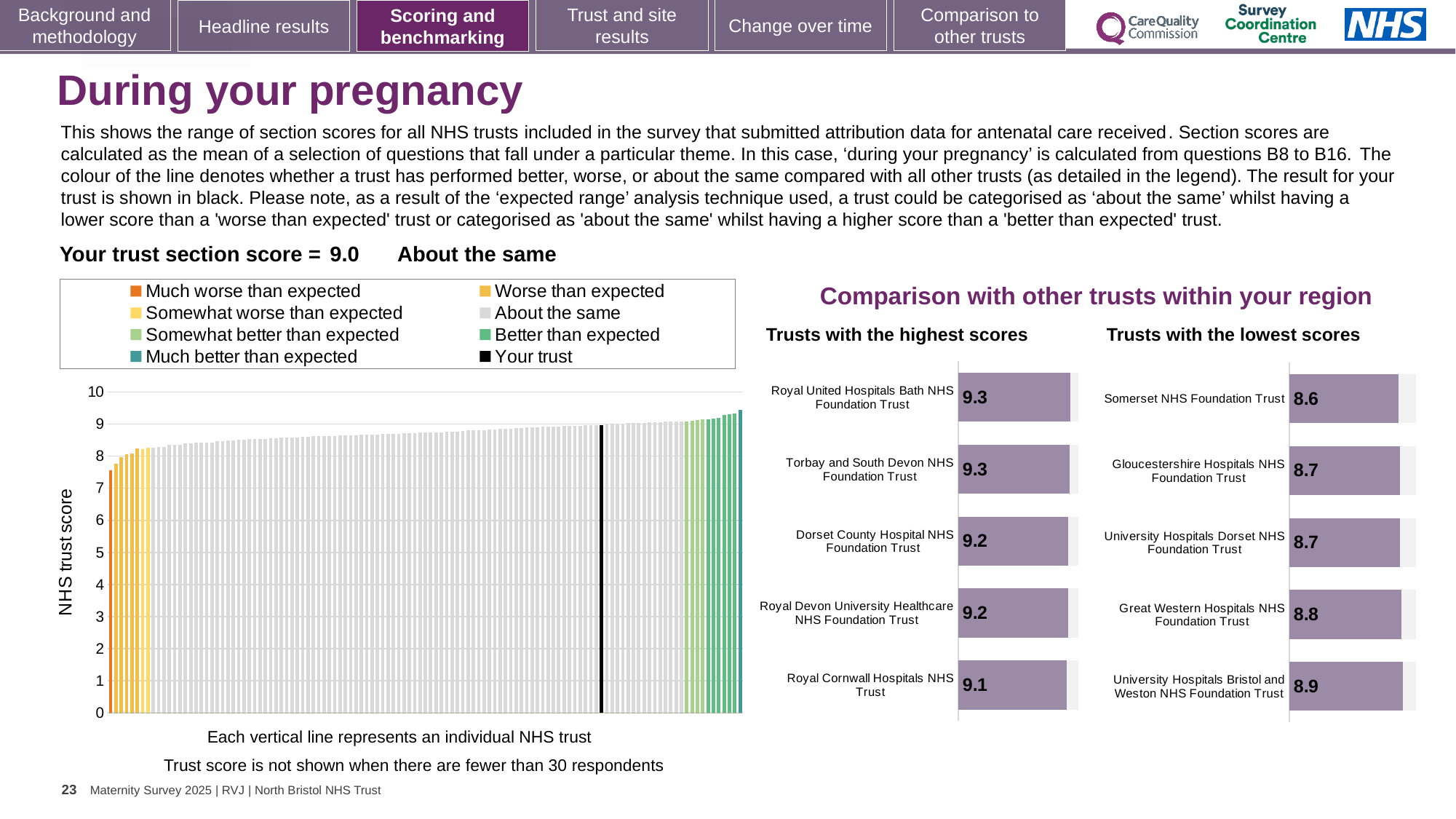
In the 'Trusts with the highest scores' chart, which trust has the lowest score? Royal Cornwall Hospitals NHS Trust How many entries does the legend above the 'NHS trust score' chart list? 8 In the 'Trusts with the highest scores' chart, what is the score for Royal Cornwall Hospitals NHS Trust? 9.1 In the 'NHS trust score' chart, is the value of the leftmost bar greater or less than 8? less In the 'NHS trust score' chart, do the bar values rise or fall from left to right? Rise In the 'Trusts with the lowest scores' chart, what is the difference between the scores of University Hospitals Bristol and Weston NHS Foundation Trust and Somerset NHS Foundation Trust? 0.3 How many trusts are shown in the 'Trusts with the highest scores' chart? 5 In the 'Trusts with the highest scores' chart, what is the difference between the scores of Royal United Hospitals Bath NHS Foundation Trust and Royal Cornwall Hospitals NHS Trust? 0.2 What kind of chart is the 'NHS trust score' chart on the left of the slide? Bar chart In the 'Trusts with the lowest scores' chart, which trust has the highest score? University Hospitals Bristol and Weston NHS Foundation Trust In the 'Trusts with the lowest scores' chart, which has the higher score: Great Western Hospitals NHS Foundation Trust or Gloucestershire Hospitals NHS Foundation Trust? Great Western Hospitals NHS Foundation Trust In the 'Trusts with the lowest scores' chart, what is the score for Somerset NHS Foundation Trust? 8.6